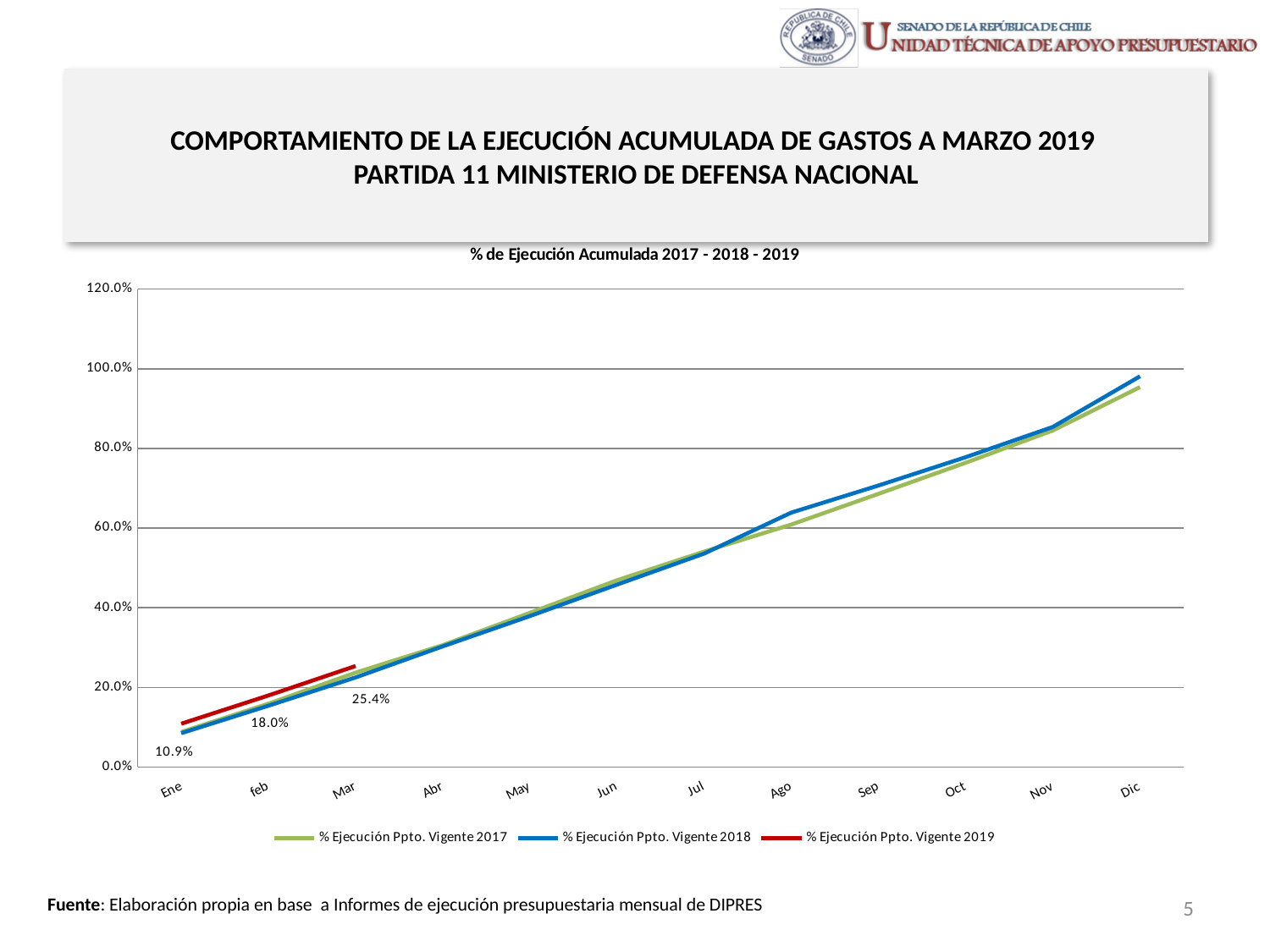
What is the difference between the 2019 values for Mar and Ene? 14.5% What is the value of % Ejecución Ppto. Vigente 2019 for Ene? 10.9% Is the value of % Ejecución Ppto. Vigente 2017 for Jun greater or less than 60.0%? less Is the value of % Ejecución Ppto. Vigente 2018 for Dic greater or less than 80.0%? greater Do the values of % Ejecución Ppto. Vigente 2018 rise or fall from Ene to Dic? rise What is the value of % Ejecución Ppto. Vigente 2019 for feb? 18.0% What kind of chart is shown on the slide? line chart How many series does the legend list? 3 Which series is drawn in red? % Ejecución Ppto. Vigente 2019 What is the title of the chart? % de Ejecución Acumulada 2017 - 2018 - 2019 How many months are shown on the x axis? 12 What is the value of % Ejecución Ppto. Vigente 2019 for Mar? 25.4%